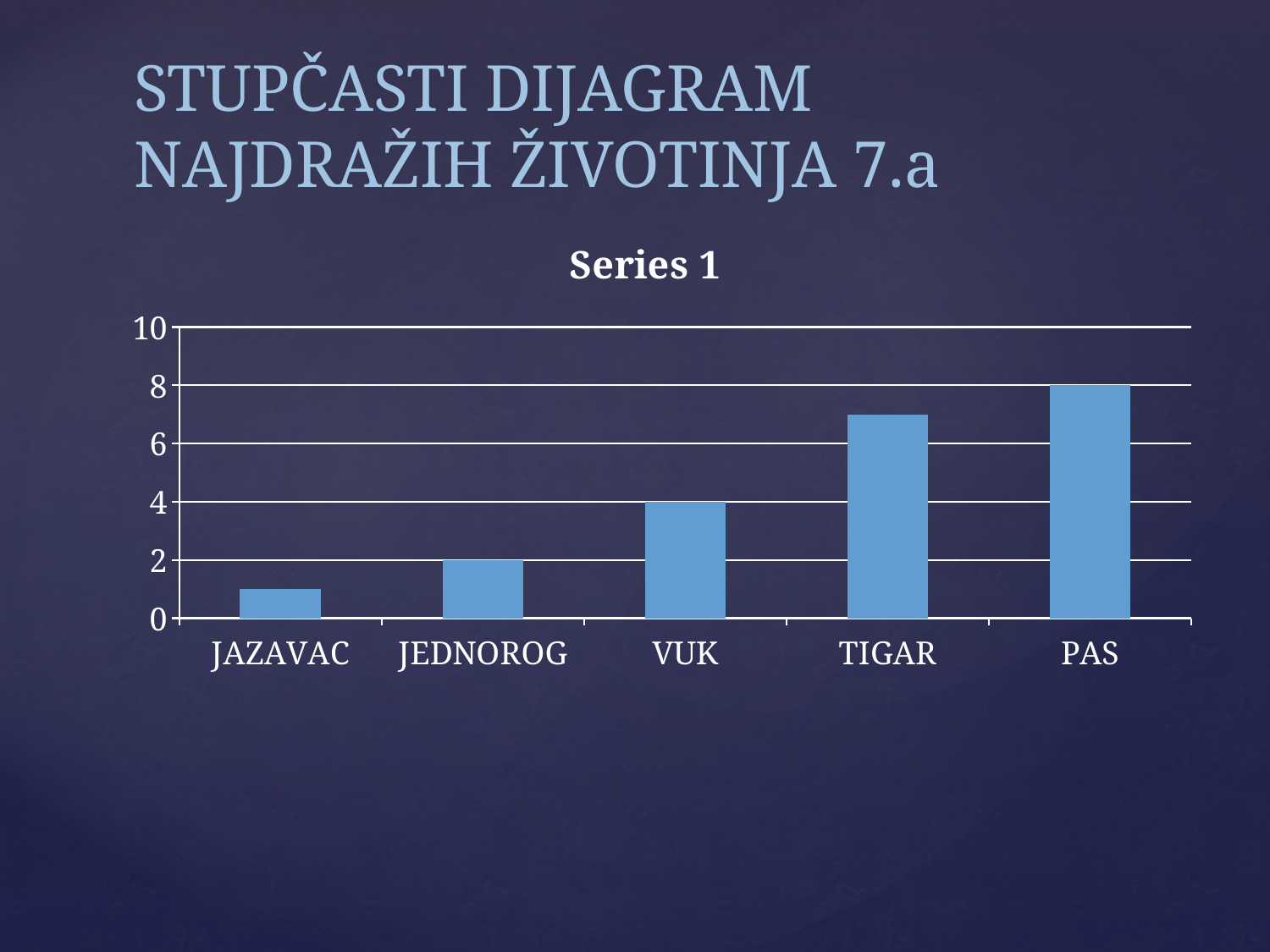
What is the title of the chart? Series 1 How many categories are shown on the x axis of the chart? 5 Is the value for TIGAR greater or less than 6? greater What kind of chart is shown on the slide? bar chart What is the value for PAS? 8 What is the difference between the values for PAS and VUK? 4 What is the value for VUK? 4 Is the value for JAZAVAC greater or less than 2? less Do the values rise or fall from left to right along the x axis? rise What is the value for JEDNOROG? 2 Which category has the highest value? PAS Which category has the lowest value? JAZAVAC